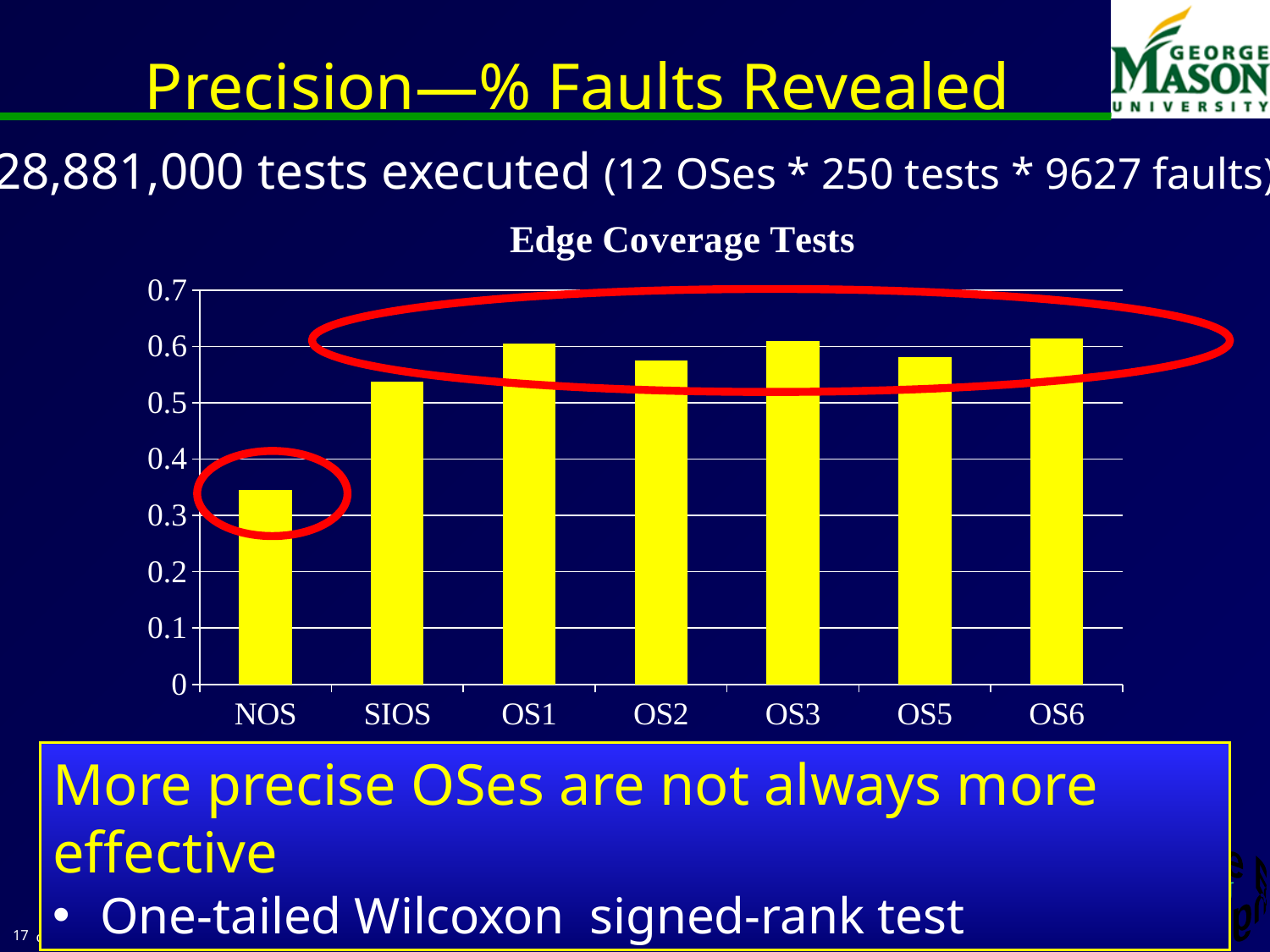
What colour are the bars in the chart? yellow What type of chart is shown on the slide? bar chart Is the value for OS5 greater or less than 0.6? less Is the value for NOS greater or less than 0.4? less What is the title of the chart? Edge Coverage Tests Which has a larger value, OS2 or NOS? OS2 How many categories are shown on the x axis of the chart? 7 Is the value for OS2 greater or less than 0.6? less Which has a larger value, NOS or SIOS? SIOS Which category has the lowest value in the chart? NOS